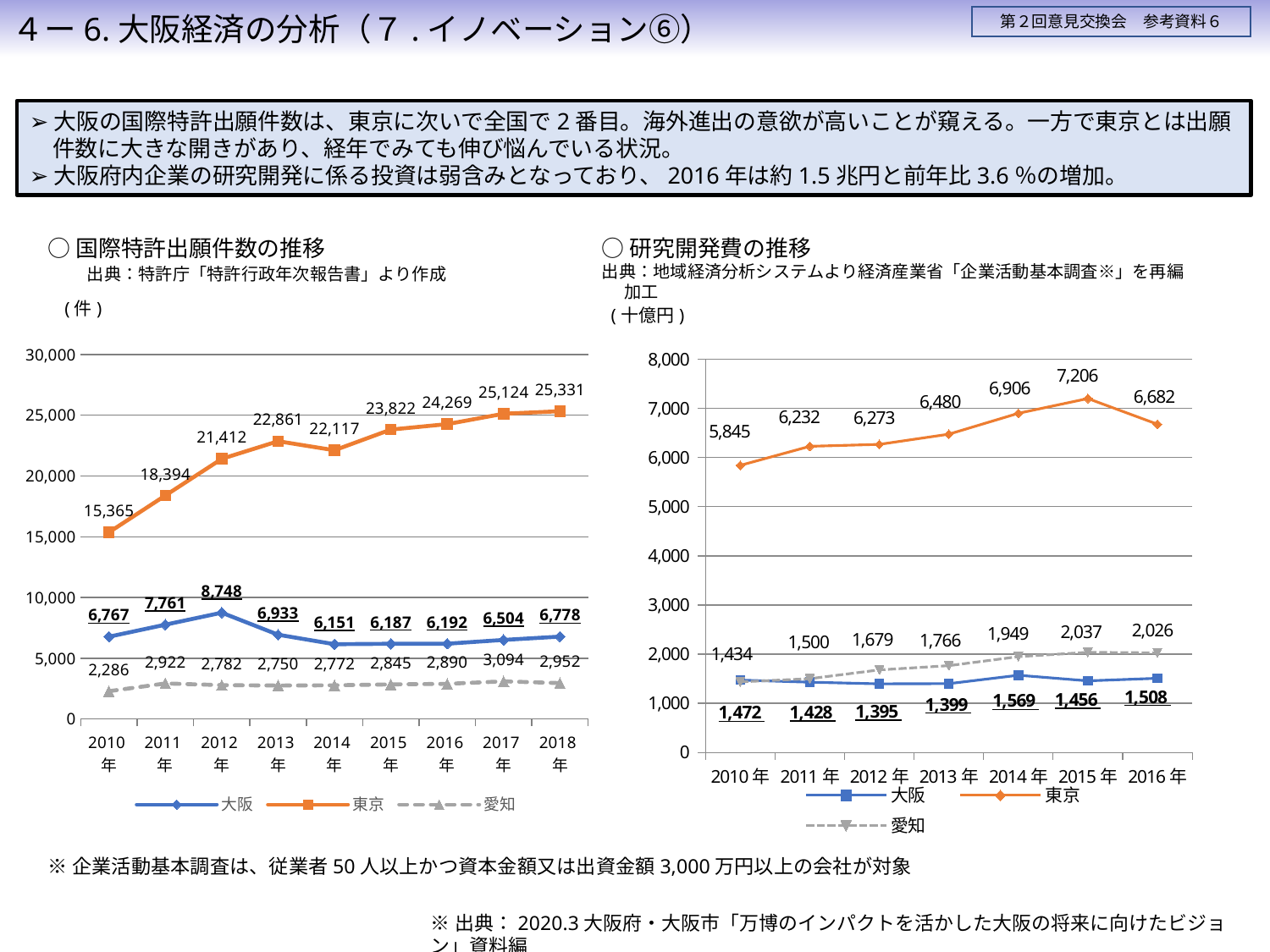
In the 国際特許出願件数の推移 chart, what is the value for 大阪 in 2012年? 8,748 In the 研究開発費の推移 chart, what is the value for 東京 in 2015年? 7,206 In the 国際特許出願件数の推移 chart, what is the difference between 東京 and 大阪 in 2018年? 18,553 In the 国際特許出願件数の推移 chart, in which year is the 大阪 series highest? 2012年 How many series does the legend of the 研究開発費の推移 chart list? 3 In the 国際特許出願件数の推移 chart, how many years are shown on the x axis? 9 In the 国際特許出願件数の推移 chart, what is the value for 東京 in 2018年? 25,331 In the 研究開発費の推移 chart, what is the value for 大阪 in 2014年? 1,569 What kind of chart is the 国際特許出願件数の推移 chart? line chart In the 研究開発費の推移 chart, what is the difference between 愛知 and 大阪 in 2015年? 581 In the 国際特許出願件数の推移 chart, in which year is the 愛知 series lowest? 2010年 In the 研究開発費の推移 chart, which is larger in 2016年, 大阪 or 愛知? 愛知